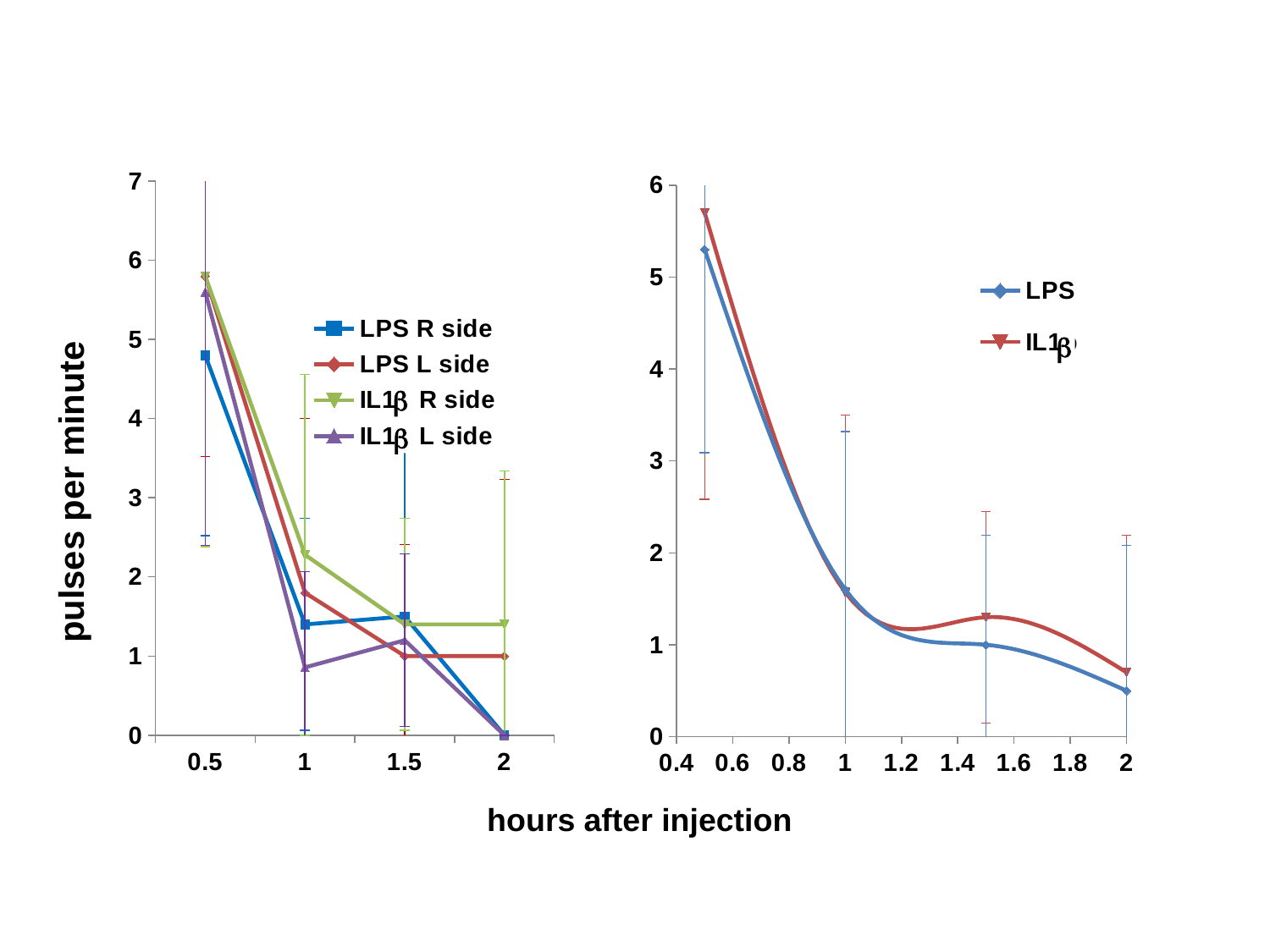
In the right chart, do the values for LPS rise or fall from 0.5 to 2 hours after injection? fall What kind of chart is the left chart on the slide? line chart What is the label of the y axis shared by the charts? pulses per minute In the right chart, is the value for IL1β at 2 hours greater or less than 1? less How many series does the legend of the right chart list? 2 In the left chart, which series has the lowest value at 0.5 hours after injection? LPS R side In the left chart, which series has the lowest value at 1 hour after injection? IL1β L side In the left chart, how many time points are plotted for each series? 4 In the left chart, which series has the highest value at 2 hours after injection? IL1β R side In the left chart, is the value for LPS R side at 0.5 hours greater or less than 4? greater In the right chart, is the value for LPS at 0.5 hours greater or less than 5? greater How many series does the legend of the left chart list? 4